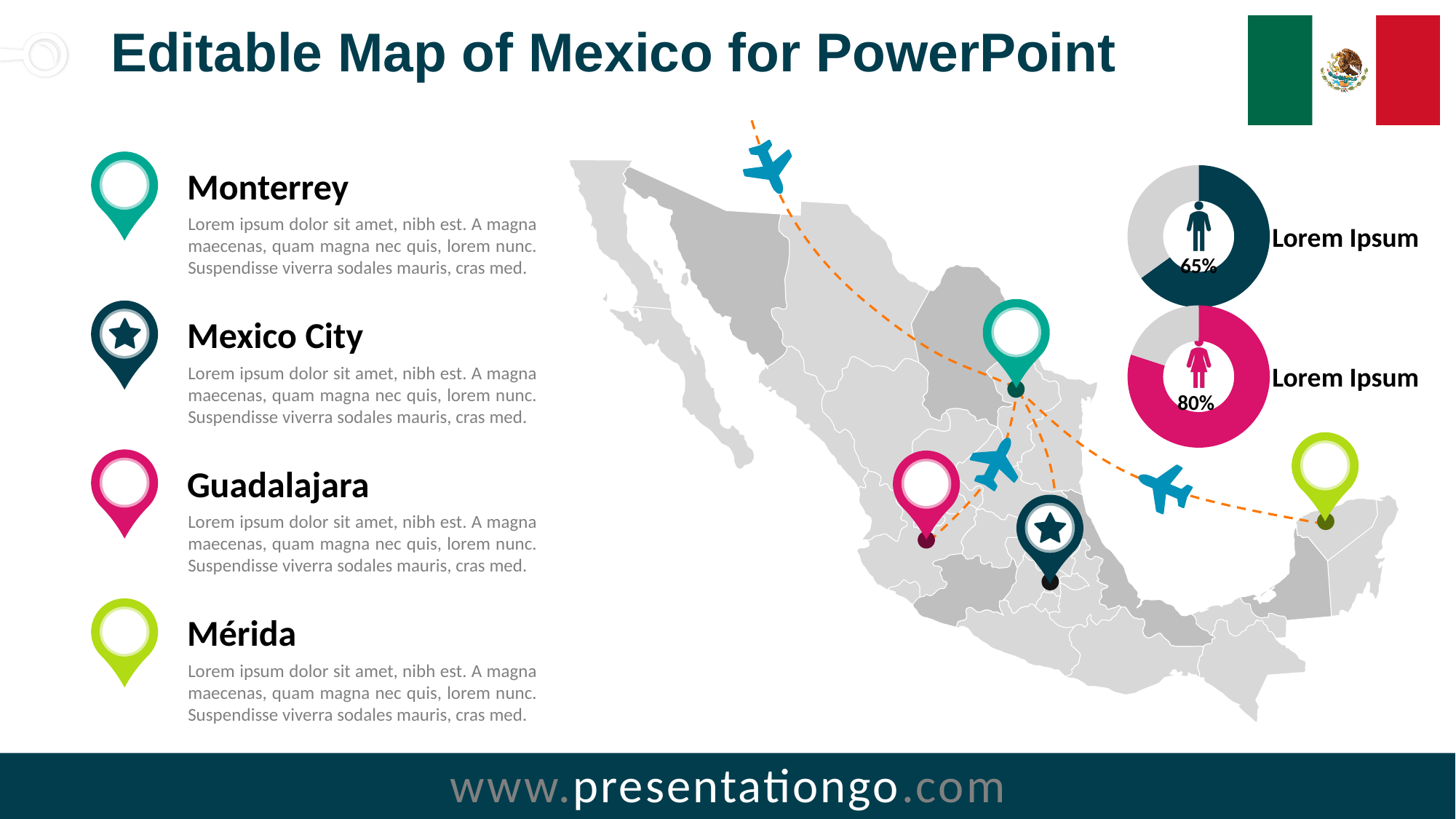
What percentage is shown in the top donut chart with the male icon? 65% What kind of chart is used to display the 65% and 80% values on the right of the slide? Donut chart Is the value in the top donut chart with the male icon greater or less than 50%? greater Is the value in the bottom donut chart with the female icon greater or less than 75%? greater What label text appears to the right of each donut chart? Lorem Ipsum How many donut charts are on the slide? 2 Which donut chart shows the larger percentage, the one with the male icon or the one with the female icon? The one with the female icon What is the difference between the percentage in the bottom donut chart (80%) and the top donut chart (65%)? 15% What colour is the filled portion of the bottom donut chart showing 80%? Pink What percentage is shown in the bottom donut chart with the female icon? 80% What share of the bottom donut chart with the female icon is left grey (unfilled)? 20% What share of the top donut chart with the male icon is not filled by the dark teal segment? 35%